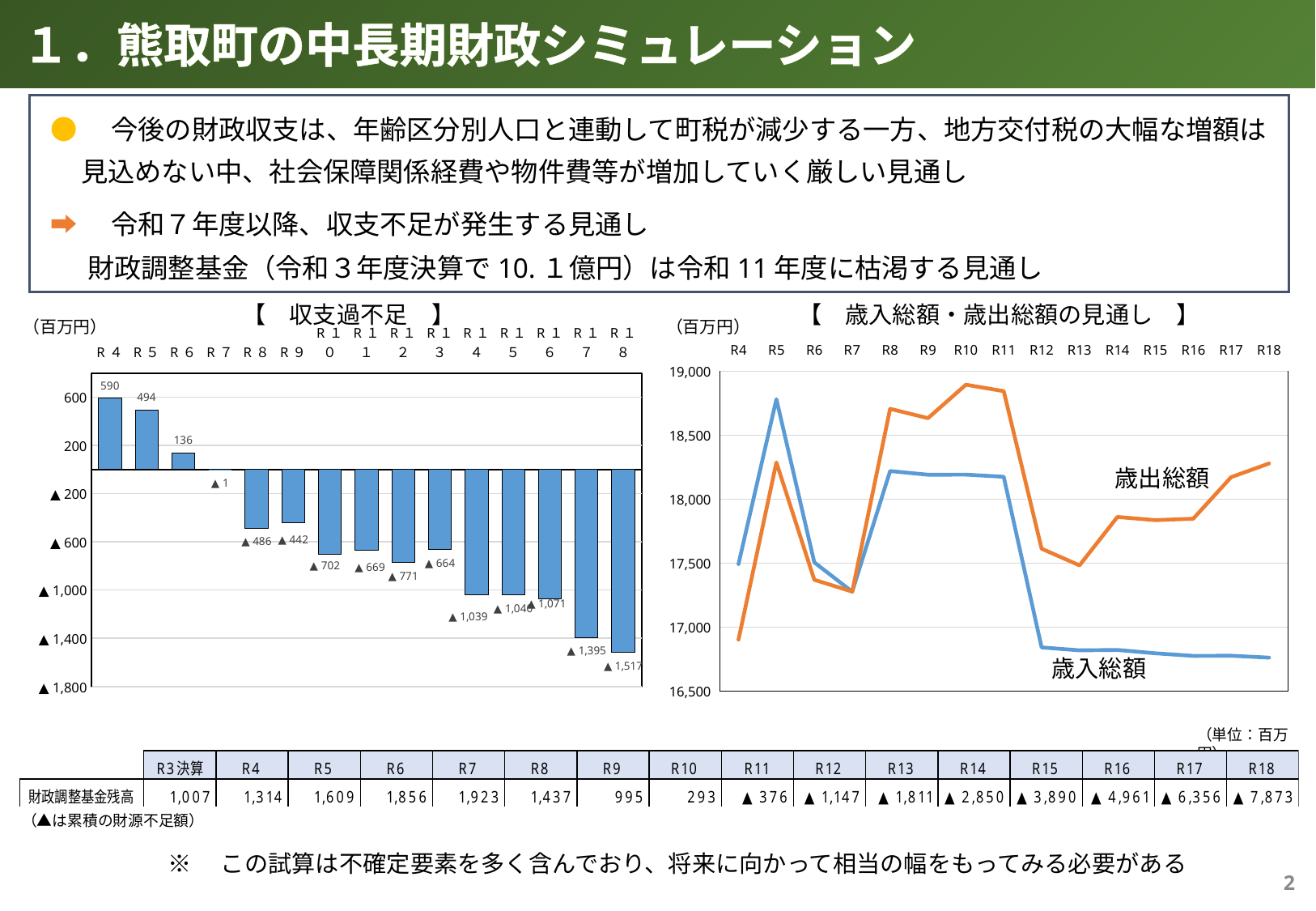
In the 収支過不足 bar chart, which year has the highest value? R4 In the 収支過不足 bar chart, what is the value for R10? ▲ 702 In the 収支過不足 bar chart, which is larger, the value for R5 or the value for R6? R5 How many series are plotted in the 歳入総額・歳出総額の見通し line chart? 2 In the 歳入総額・歳出総額の見通し chart, is the 歳出総額 value for R10 greater or less than 18,500? greater In the 収支過不足 bar chart, what is the difference between the values for R4 and R5? 96 What kind of chart is the 収支過不足 chart? bar chart How many years are plotted in the 収支過不足 bar chart? 15 In the 歳入総額・歳出総額の見通し chart, is the 歳入総額 value for R18 greater or less than 17,000? less In the 収支過不足 bar chart, what is the value for R4? 590 In the 収支過不足 bar chart, which year has the lowest value? R18 In the 収支過不足 bar chart, what is the value for R18? ▲ 1,517